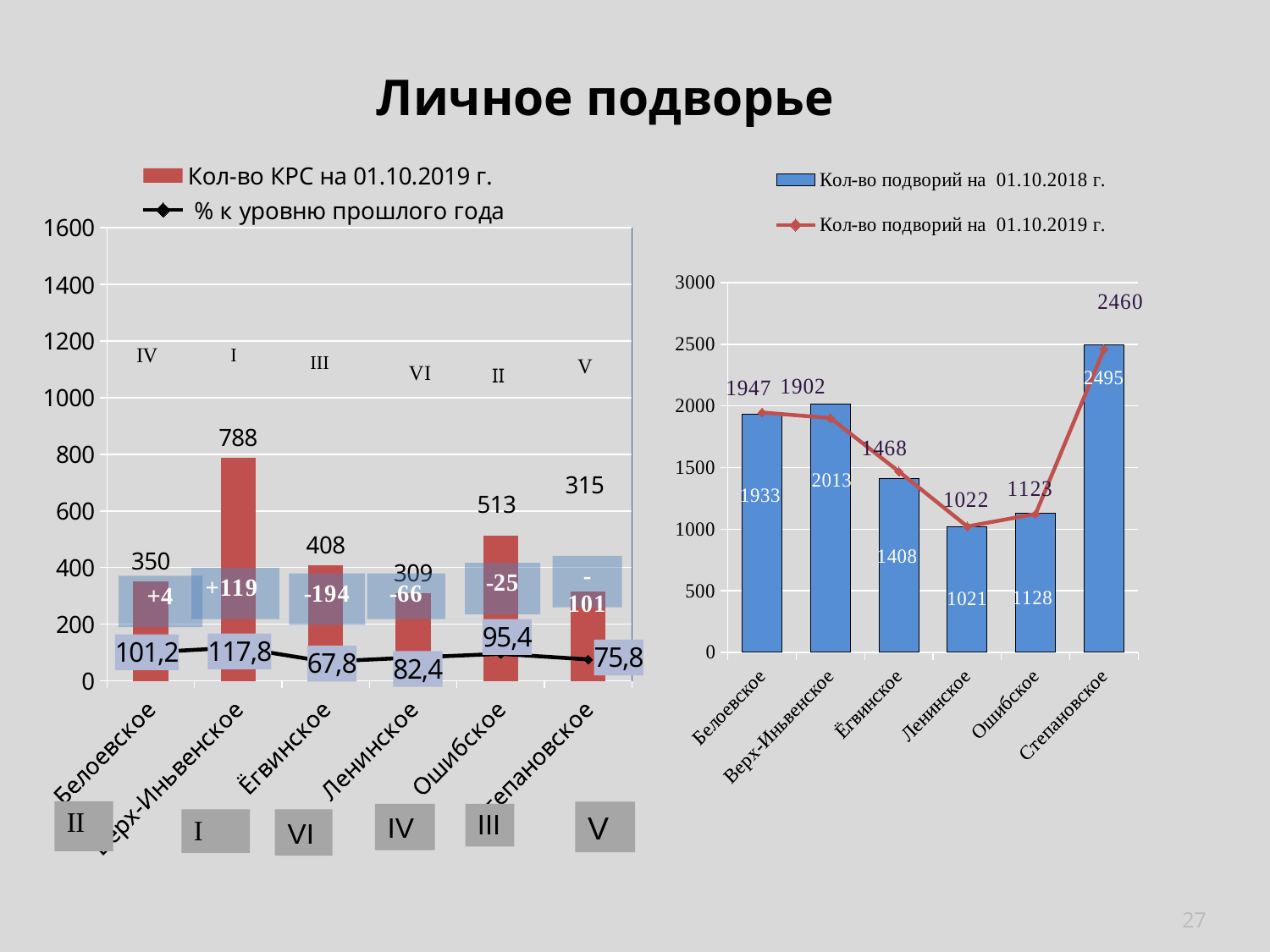
On the left chart, what is the value of Кол-во КРС на 01.10.2019 г. for Верх-Иньвенское? 788 On the right chart, how many categories are shown on the x axis? 6 On the left chart, which category has the highest Кол-во КРС на 01.10.2019 г.? Верх-Иньвенское On the right chart, what is the value of Кол-во подворий на 01.10.2018 г. for Ёгвинское? 1408 On the right chart, which is larger for Верх-Иньвенское: Кол-во подворий на 01.10.2018 г. or Кол-во подворий на 01.10.2019 г.? Кол-во подворий на 01.10.2018 г. On the right chart, which category has the lowest Кол-во подворий на 01.10.2018 г.? Ленинское What type of chart is the right chart? Combined bar and line chart On the left chart, how many series does the legend list? 2 On the left chart, what is the difference in Кол-во КРС на 01.10.2019 г. between Ошибское and Белоевское? 163 On the left chart, which category has the lowest Кол-во КРС на 01.10.2019 г.? Ленинское On the right chart, what is the value of Кол-во подворий на 01.10.2019 г. for Степановское? 2460 On the left chart, what is the value of % к уровню прошлого года for Ёгвинское? 67,8